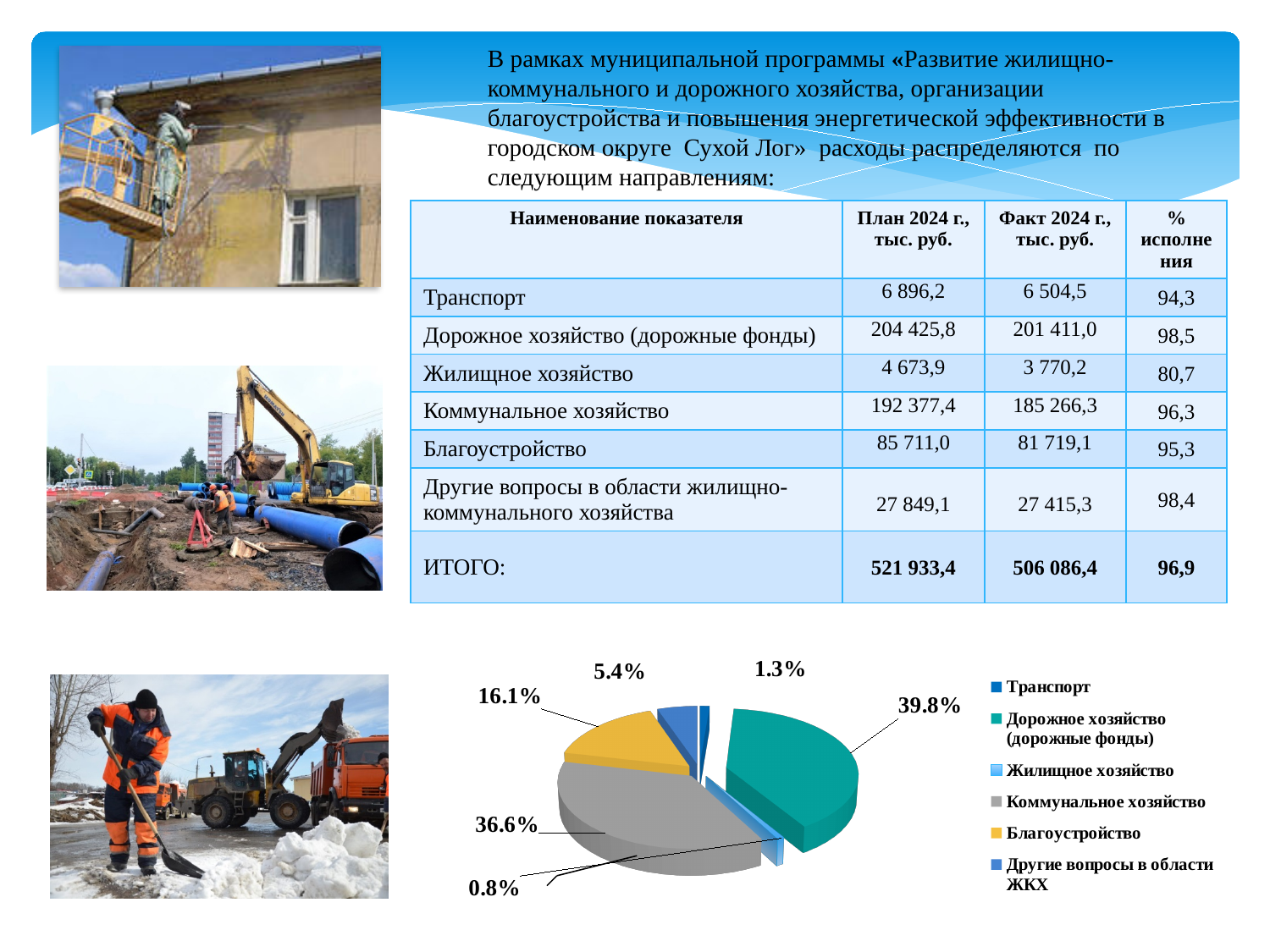
In the pie chart, what share is shown for Жилищное хозяйство? 0.8% What kind of chart is shown at the bottom of the slide? pie chart In the pie chart, what share is shown for Дорожное хозяйство (дорожные фонды)? 39.8% In the pie chart, what share is shown for Коммунальное хозяйство? 36.6% How many categories does the pie chart legend list? 6 In the pie chart, what is the difference between the shares for Дорожное хозяйство (дорожные фонды) and Коммунальное хозяйство? 3.2% In the pie chart, which is larger: the share for Благоустройство or the share for Другие вопросы в области ЖКХ? Благоустройство Which category has the largest slice in the pie chart? Дорожное хозяйство (дорожные фонды) Which category has the smallest slice in the pie chart? Жилищное хозяйство